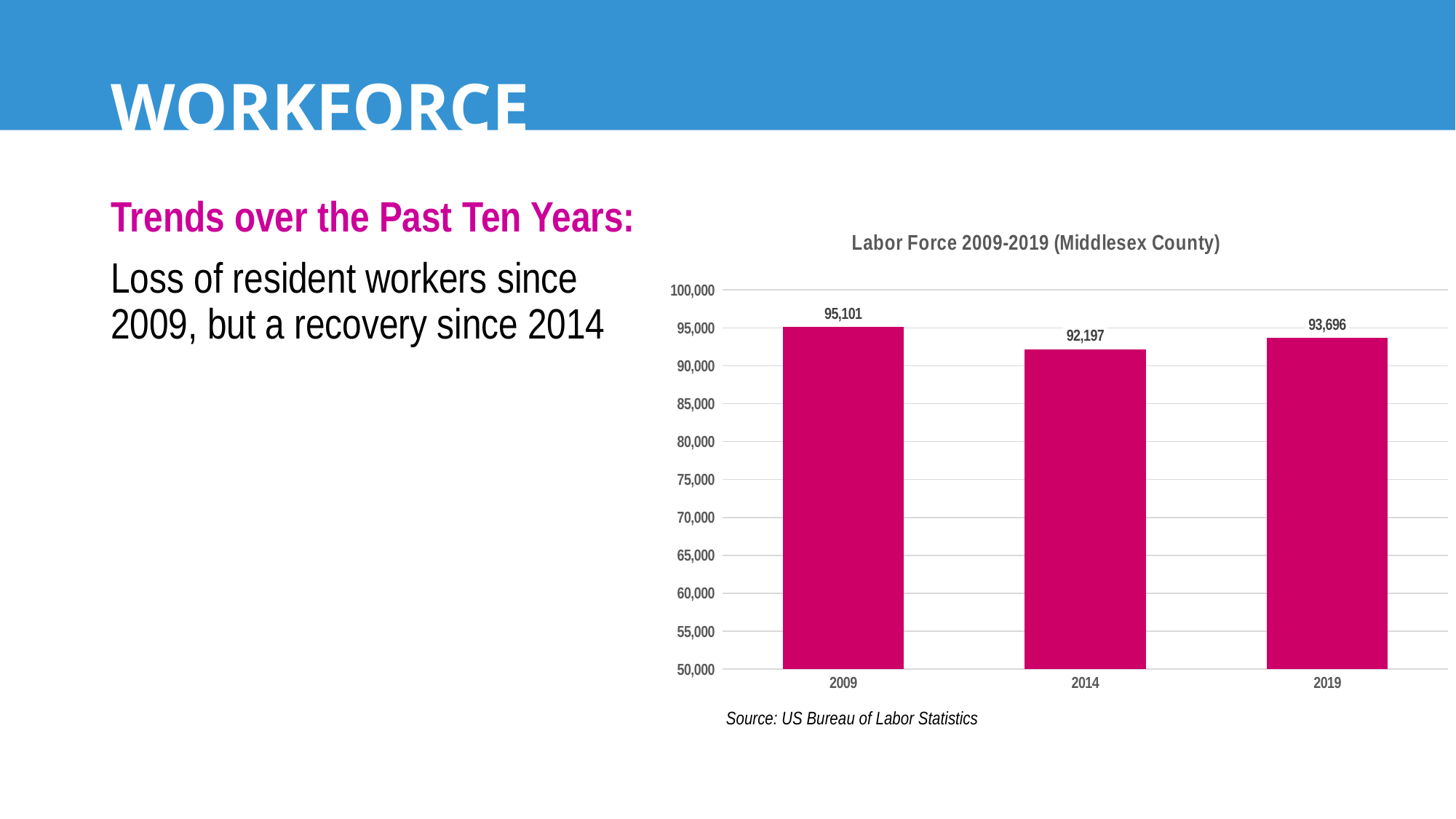
What kind of chart is shown on the slide? bar chart Is the value for 2014 greater or less than 95,000? less What is the difference between the labor force in 2009 and 2014? 2,904 What is the labor force value for 2009? 95,101 What is the labor force value for 2019? 93,696 What is the labor force value for 2014? 92,197 How many years are shown on the chart? 3 What is the title of the chart? Labor Force 2009-2019 (Middlesex County) Which year has the highest labor force value? 2009 Which is larger, the labor force in 2009 or in 2019? 2009 What is the difference between the labor force in 2019 and 2014? 1,499 Which year has the lowest labor force value? 2014